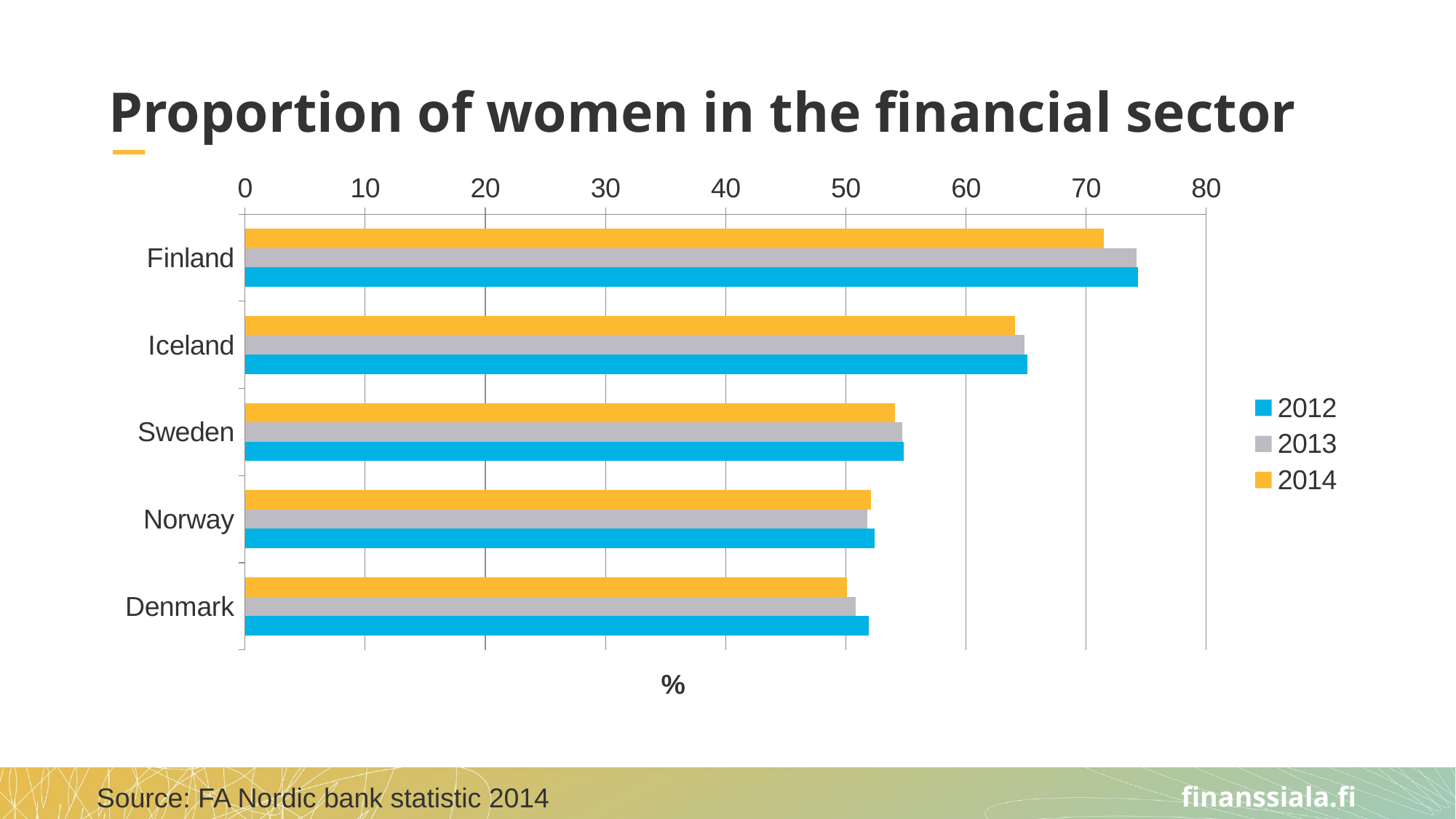
Which country has the lowest proportion of women in the financial sector in 2014? Denmark How many series does the legend list? 3 Is the value for Sweden in 2014 greater or less than 50? greater How many countries are shown on the chart? 5 What kind of chart is shown on the slide? Bar chart What is the title of the chart? Proportion of women in the financial sector Is the value for Iceland in 2012 greater or less than 60? greater Which country has the highest proportion of women in the financial sector in 2012? Finland Is the value for Finland in 2014 greater or less than 70? greater Which is larger in 2013, the value for Iceland or the value for Sweden? Iceland Which is larger in 2014, the value for Finland or the value for Iceland? Finland